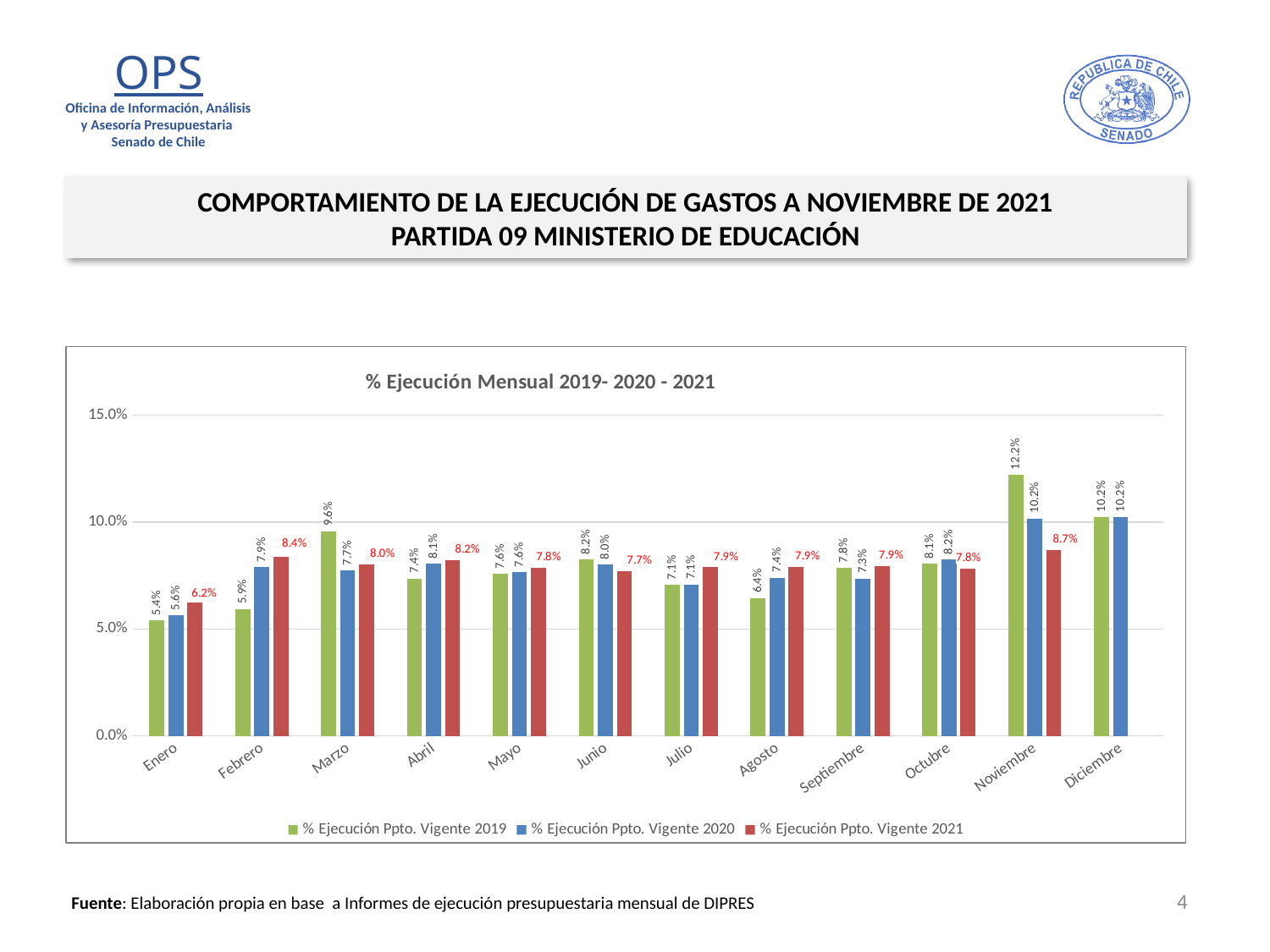
What is the title of the chart? % Ejecución Mensual 2019- 2020 - 2021 What is the difference between the 2019 and 2021 values in Noviembre? 3.5% Which month has no bar for % Ejecución Ppto. Vigente 2021? Diciembre How many months are shown on the x axis? 12 In which month is the % Ejecución Ppto. Vigente 2021 series lowest? Enero What kind of chart is shown? Bar chart What is the value for % Ejecución Ppto. Vigente 2020 in Enero? 5.6% How many series does the legend list? 3 What is the value for % Ejecución Ppto. Vigente 2019 in Marzo? 9.6% What is the value for % Ejecución Ppto. Vigente 2021 in Noviembre? 8.7% In which month is the % Ejecución Ppto. Vigente 2019 series highest? Noviembre Which is larger in Febrero: the 2019 value or the 2021 value? 2021 value (8.4%)